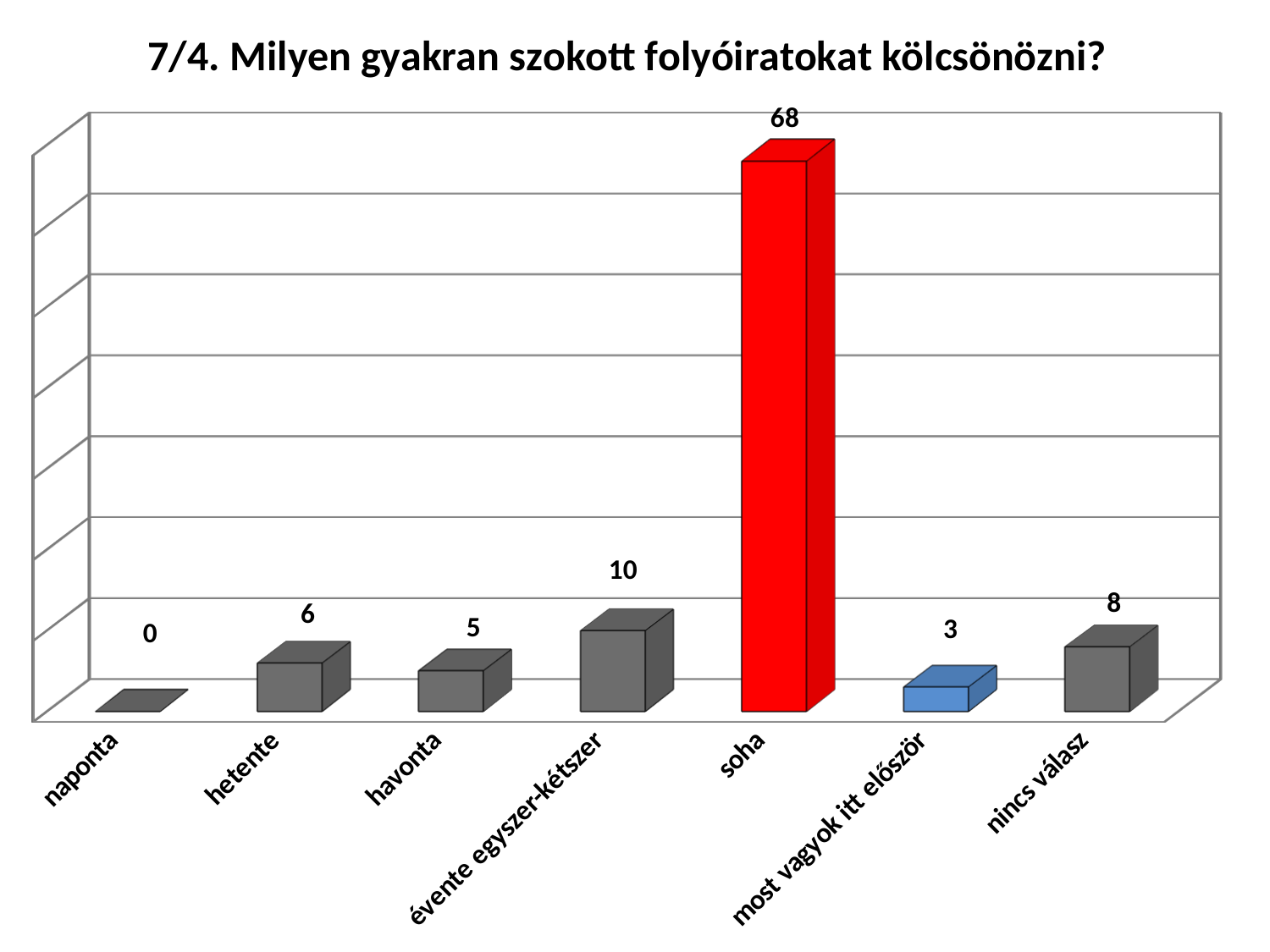
How many categories are shown on the x axis? 7 What is the value for "soha"? 68 What is the difference between the values for "soha" and "nincs válasz"? 60 What kind of chart is shown on the slide? bar chart What is the title of the chart? 7/4. Milyen gyakran szokott folyóiratokat kölcsönözni? Which category has the highest value? soha What is the value for "most vagyok itt először"? 3 Which is larger, the value for "nincs válasz" or the value for "hetente"? nincs válasz Which category has the lowest value? naponta What is the value for "évente egyszer-kétszer"? 10 What is the value for "naponta"? 0 What is the difference between the values for "hetente" and "havonta"? 1